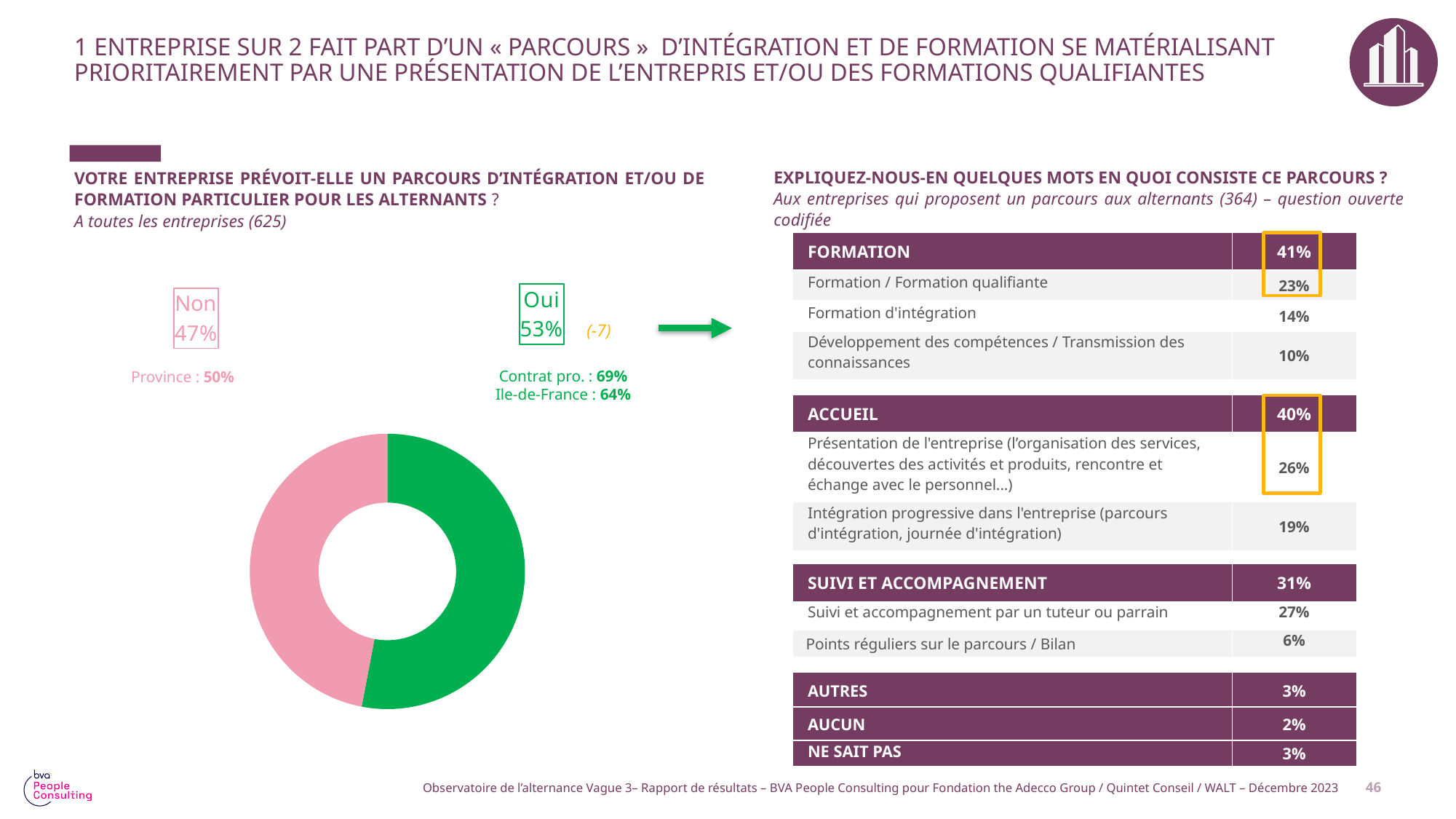
What is the change shown next to the "Oui" value in the donut chart? -7 What kind of chart is shown on the left of the slide? Donut (pie) chart How many slices does the donut chart have? 2 What share of companies answered "Non" in the donut chart? 47% What is the difference in percentage points between the "Oui" and "Non" slices? 6 points Which answer has the larger slice in the donut chart, "Oui" or "Non"? Oui What is the "Oui" share for companies with a "Contrat pro." shown beside the donut chart? 69% What is the "Non" share for companies in Province shown beside the donut chart? 50% What colour is the "Non" slice in the donut chart? Pink Which answer has the smallest slice in the donut chart? Non What share of companies answered "Oui" in the donut chart? 53% What colour is the "Oui" slice in the donut chart? Green